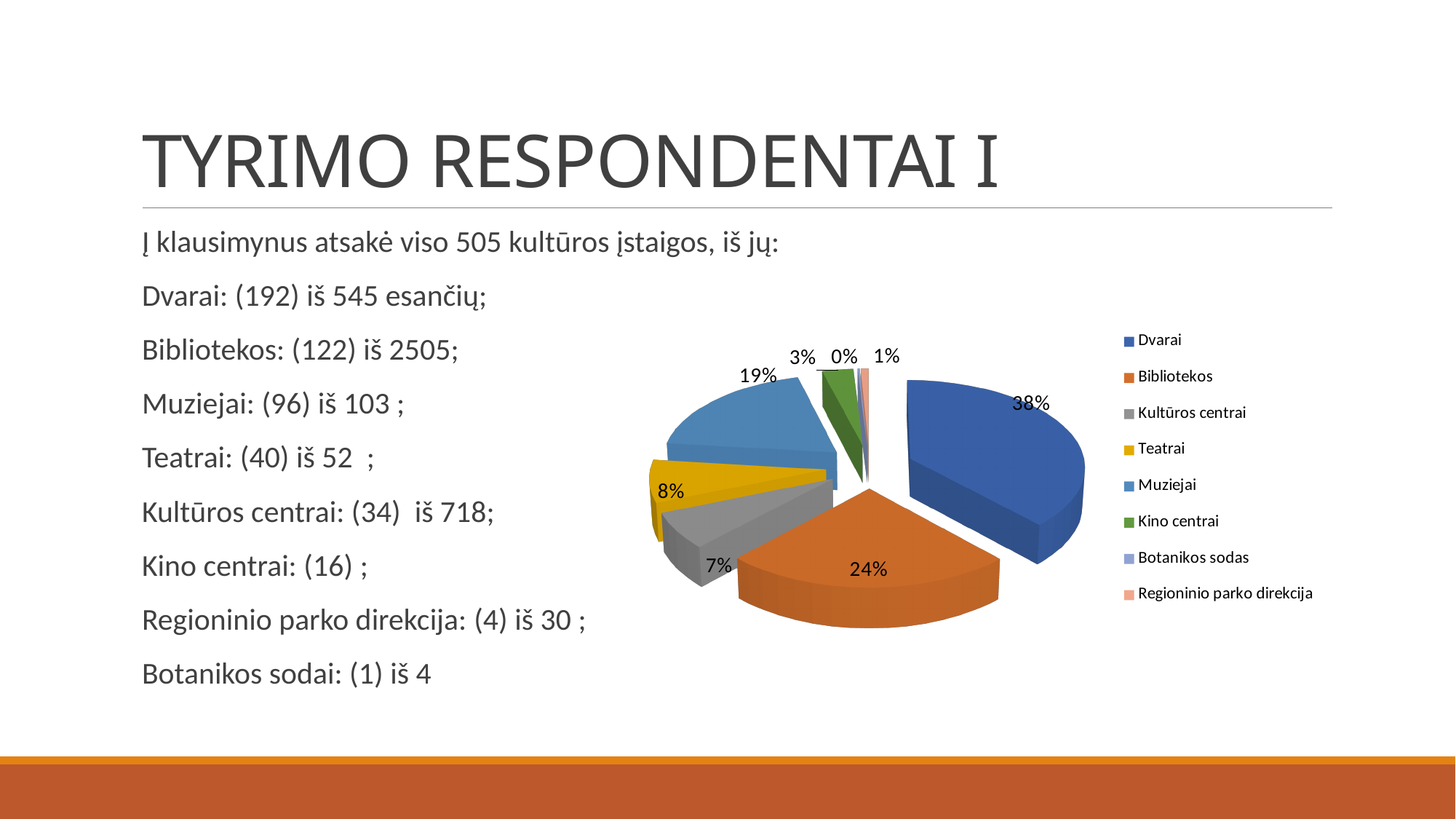
Which category has the largest slice of the pie? Dvarai Which category has the smallest slice of the pie? Botanikos sodas What is the difference in percentage points between the Dvarai slice and the Bibliotekos slice? 14 Which slice is larger, Teatrai or Kultūros centrai? Teatrai What share of the pie does Dvarai have? 38% What share of the pie does Bibliotekos have? 24% How many categories does the legend of the pie chart list? 8 What kind of chart is shown on the slide? pie chart What share of the pie does Kultūros centrai have? 7%